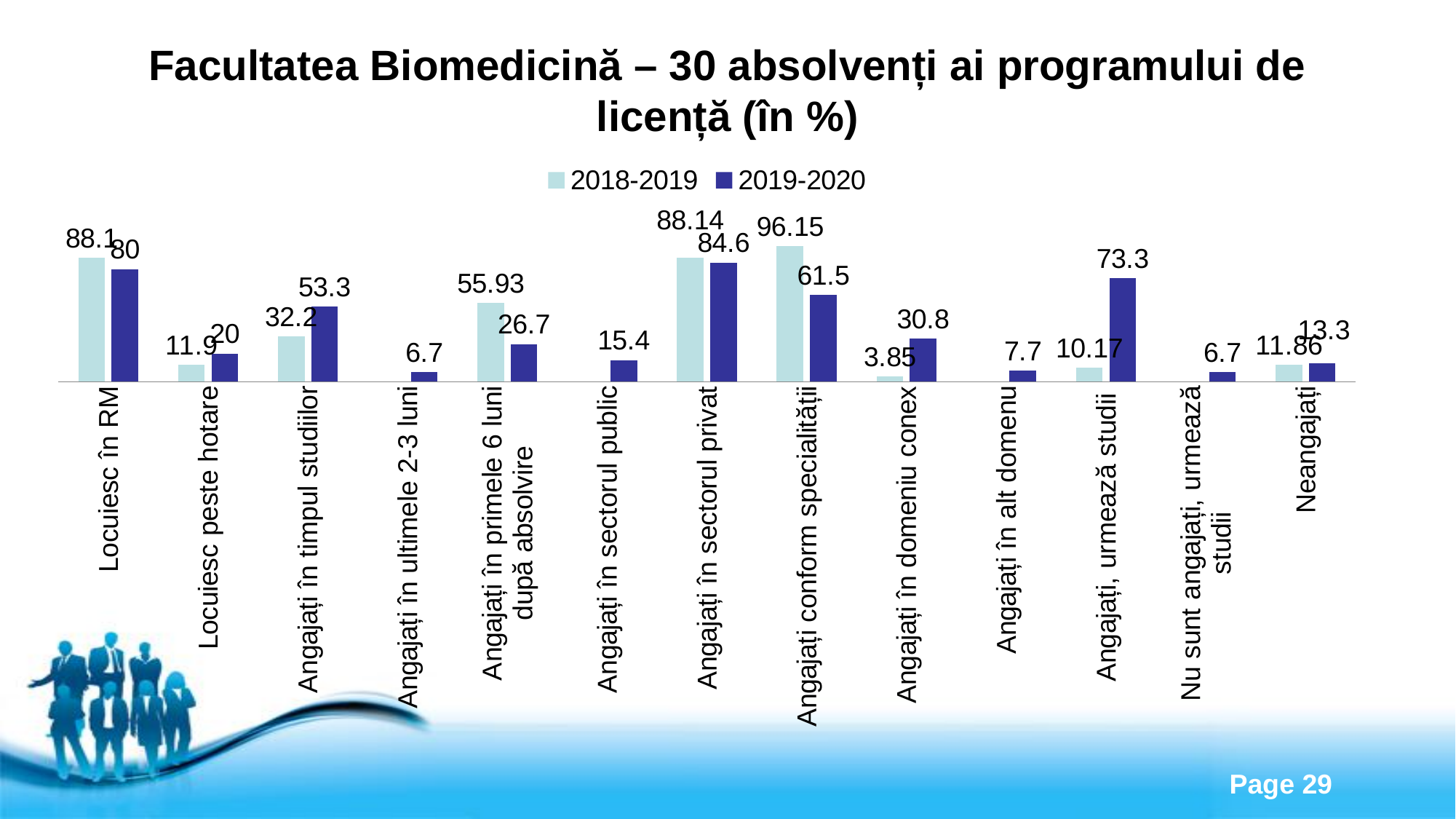
What is the 2018-2019 value for "Locuiesc peste hotare"? 11.9 Which category has the highest 2018-2019 value? Angajați conform specialității What is the 2019-2020 value for "Angajați, urmează studii"? 73.3 What kind of chart is shown on the slide? Bar chart How many series does the legend list? 2 What is the 2018-2019 value for "Angajați conform specialității"? 96.15 What is the difference between the 2018-2019 and 2019-2020 values for "Locuiesc în RM"? 8.1 Which category has the lowest 2018-2019 value? Angajați în domeniu conex How many categories are shown on the x axis? 13 What is the 2019-2020 value for "Angajați în sectorul public"? 15.4 Which series has the larger value for "Angajați în primele 6 luni după absolvire", 2018-2019 or 2019-2020? 2018-2019 Which category has the highest 2019-2020 value? Angajați în sectorul privat